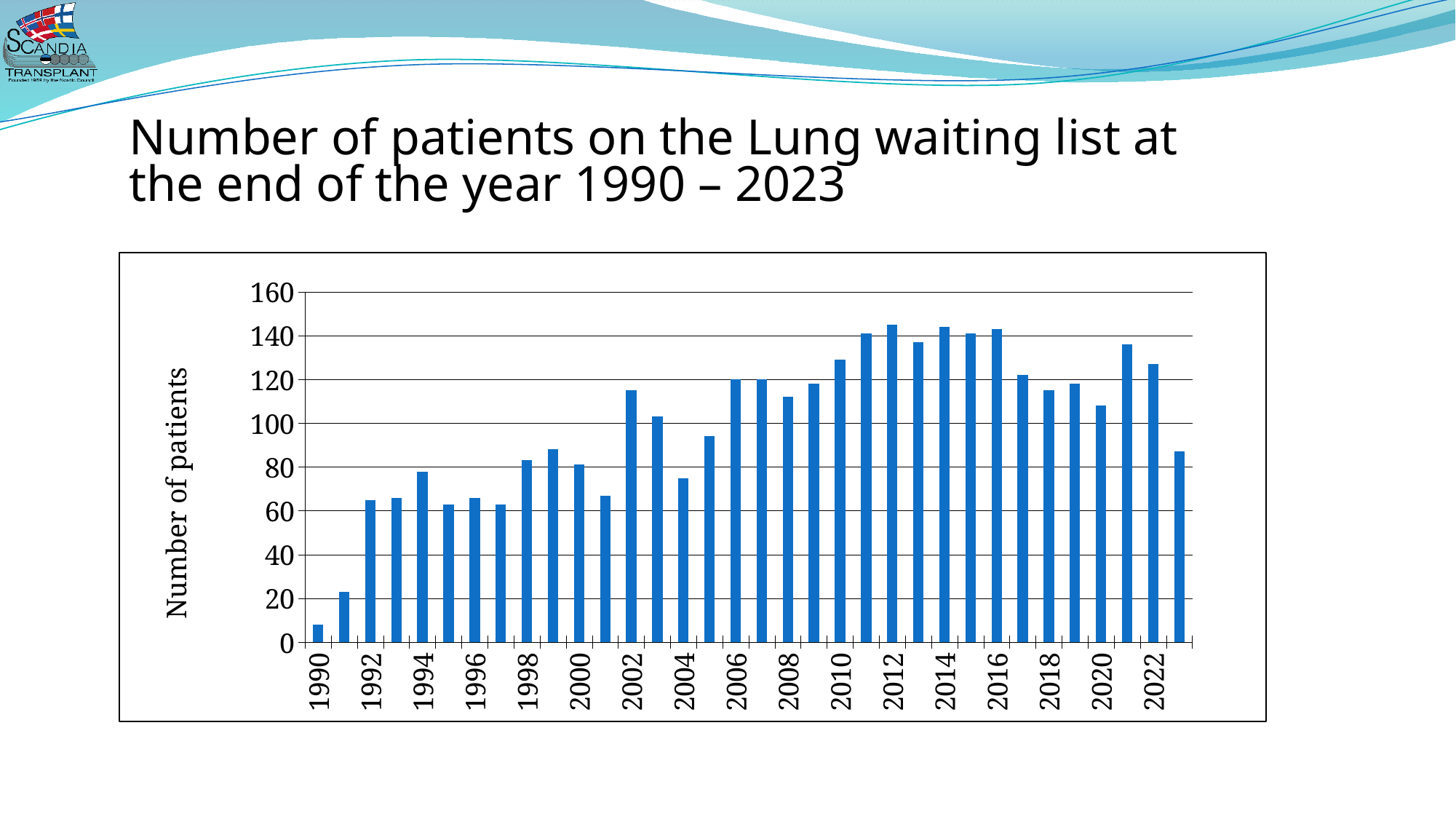
Is the value for 2023 greater or less than 100? less Is the value for 1990 greater or less than 20? less Is the value for 2012 greater or less than 140? greater Which year has the larger value, 2002 or 2004? 2002 What is the label on the vertical axis of the chart? Number of patients Do the values rise or fall from 1990 to 1992? Rise How many years (bars) are plotted in the chart? 34 Which year has the lowest number of patients on the lung waiting list? 1990 Which year has the larger value, 2022 or 2023? 2022 What kind of chart is shown on the slide? Bar chart